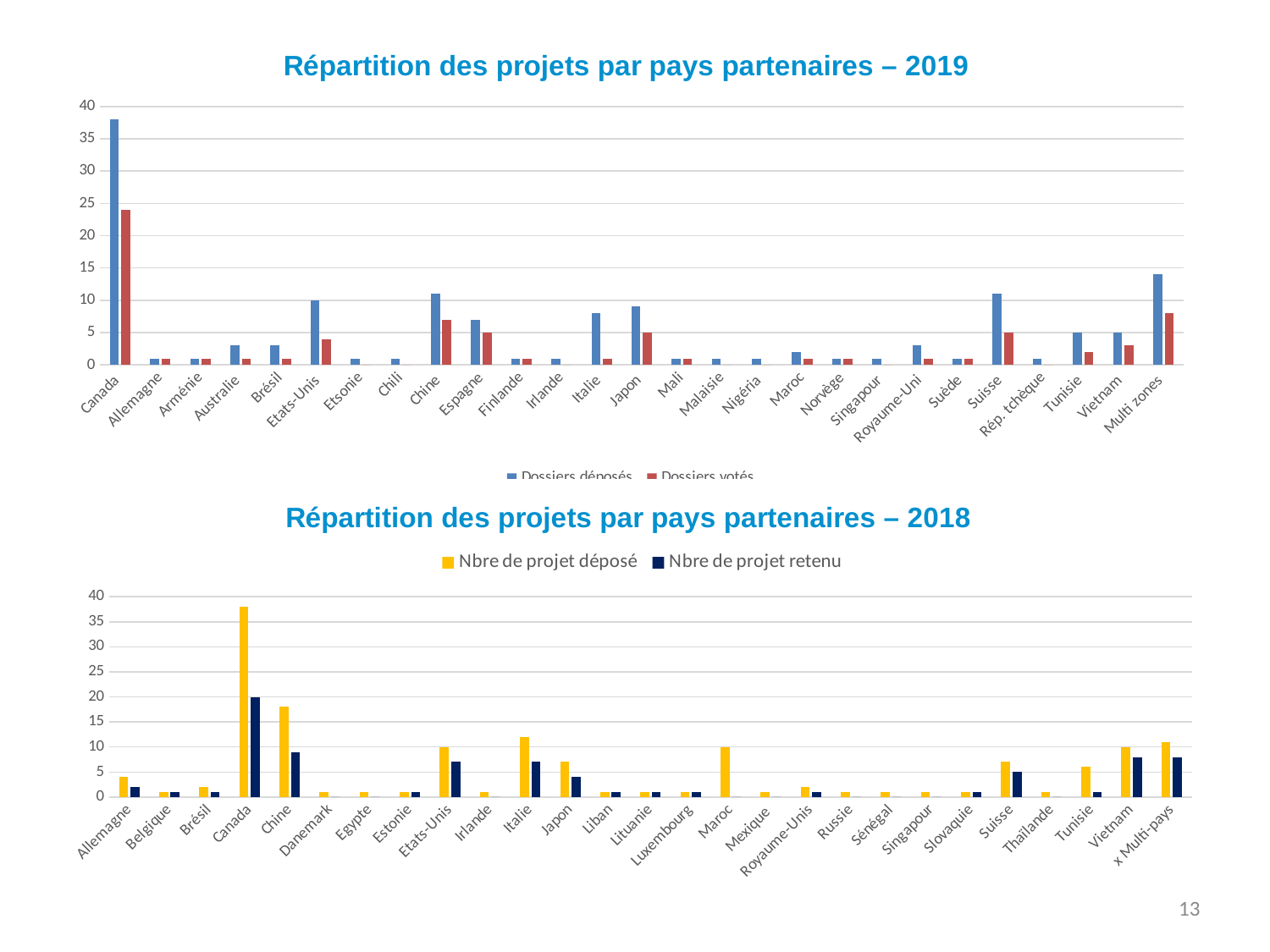
In the 2019 chart, is the Dossiers déposés value for Canada greater or less than 35? greater In the 2018 chart, what is the Nbre de projet déposé value for Maroc? 10 In the 2019 chart, what is the Dossiers déposés value for Etats-Unis? 10 In the 2018 chart, which is larger: the Nbre de projet déposé for Chine or for Italie? Chine In the 2019 chart, is the Dossiers déposés value for Multi zones greater or less than 10? greater In the 2018 chart, what is the Nbre de projet retenu value for Canada? 20 In the 2018 chart, how many series does the legend list? 2 In the 2018 chart, which country has the highest Nbre de projet déposé? Canada In the 2018 chart, what are the two legend entries? Nbre de projet déposé, Nbre de projet retenu In the 2019 chart, which country has the highest number of Dossiers déposés? Canada In the 2019 chart, is the Dossiers votés value for Canada greater or less than 20? greater What kind of chart is the 2019 chart "Répartition des projets par pays partenaires – 2019"? bar chart